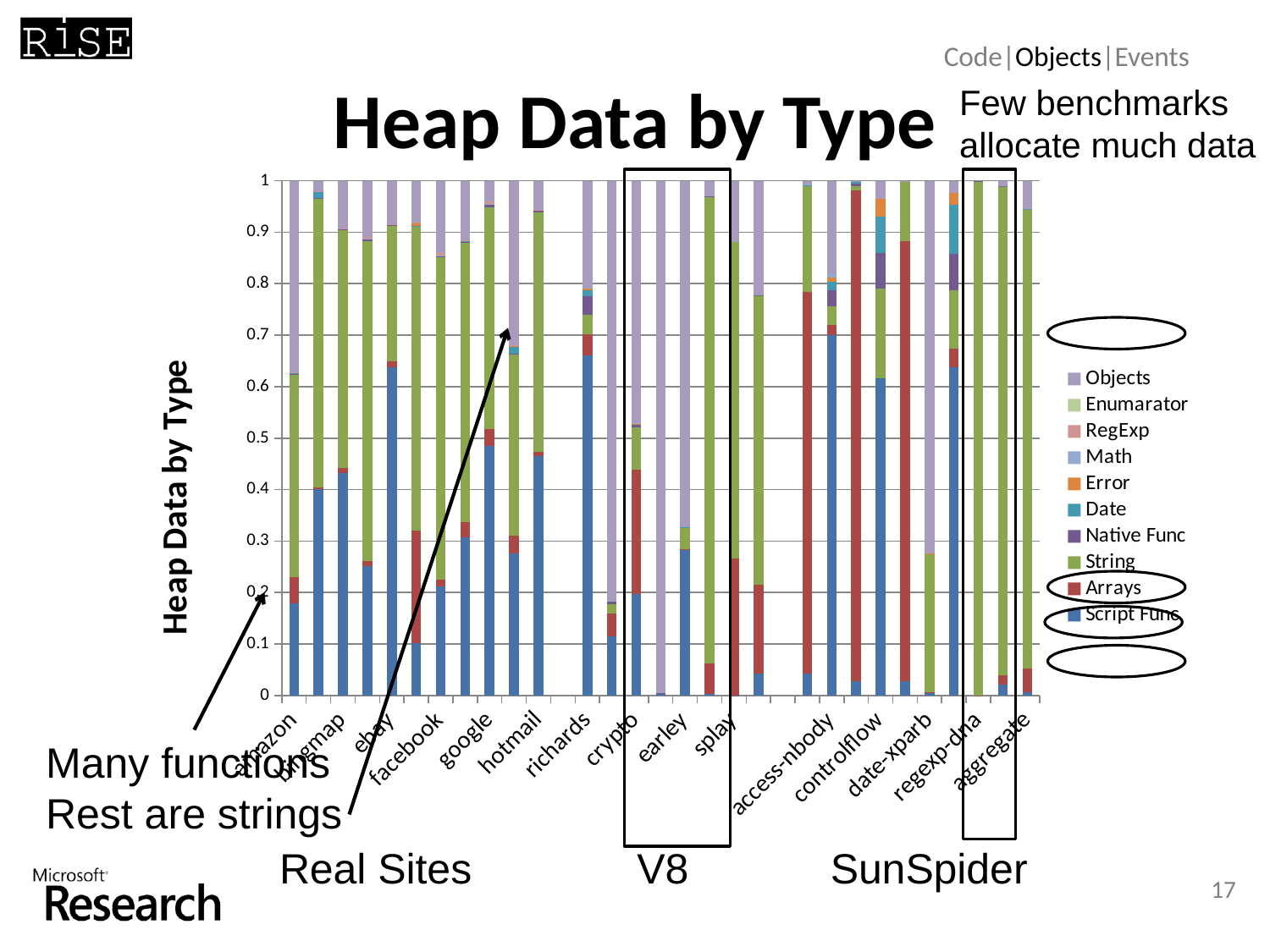
Which legend entry is listed first (at the top) in the chart's legend? Objects Is the Script Func value for aggregate greater or less than 0.1? less Is the Script Func value for amazon greater or less than 0.3? less How many series does the legend of the chart list? 10 Is the top of the String segment for aggregate greater or less than 0.9? greater What kind of chart is shown on the slide? Stacked bar chart How many benchmark groups are labelled beneath the chart (Real Sites, V8, SunSpider)? 3 What is the title of the chart? Heap Data by Type